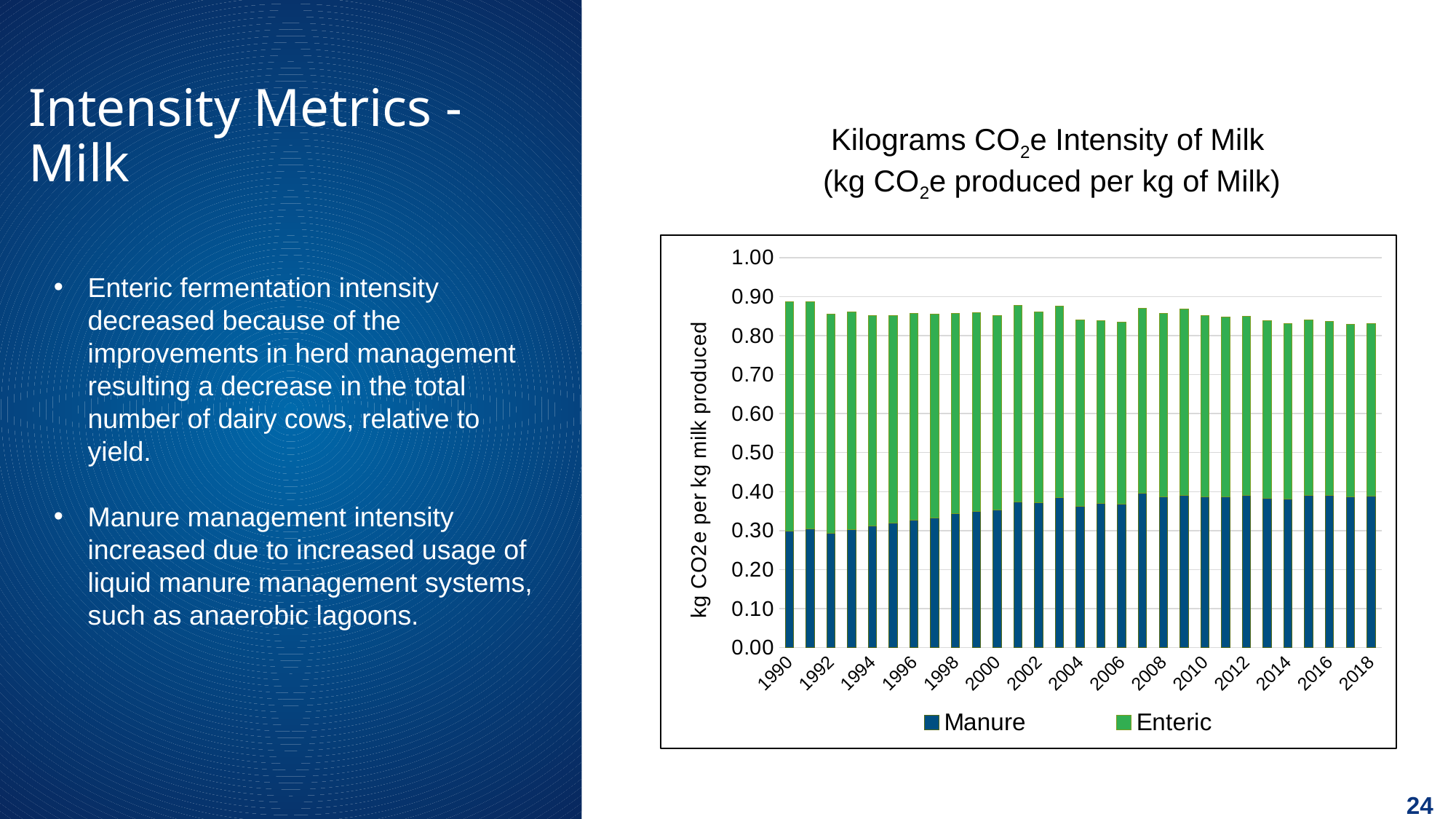
Is the total stacked value for 1990 greater or less than 0.80? greater Is the Manure value for 2018 greater or less than 0.30? greater Which year has the larger Manure value, 1990 or 2018? 2018 Which two series are listed in the chart legend? Manure and Enteric What is the label on the vertical axis of the chart? kg CO2e per kg milk produced Does the Manure series generally rise or fall from 1990 to 2018? Rise Is the total stacked value for 2018 greater or less than 0.90? less What kind of chart is shown on the slide? Stacked bar chart Which year has the larger Enteric value, 1990 or 2018? 1990 Which year has the larger total stacked value, 1990 or 2018? 1990 How many series does the legend list? 2